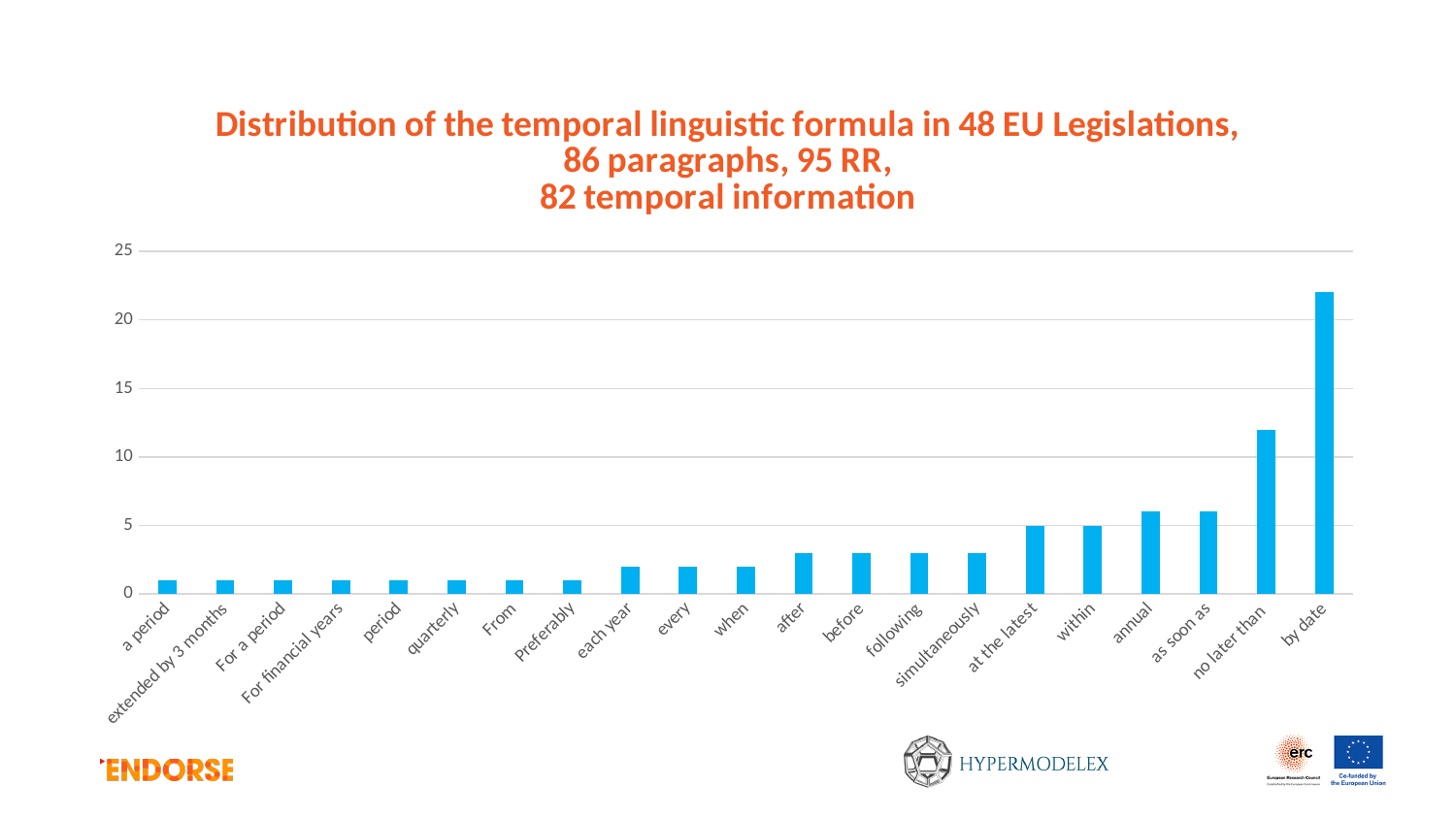
Which category has the highest value? by date How many categories are shown on the x axis? 21 What is the title of the chart? Distribution of the temporal linguistic formula in 48 EU Legislations, 86 paragraphs, 95 RR, 82 temporal information Which is larger, the value for 'annual' or the value for 'after'? annual Do the values generally rise or fall from left to right along the x axis? rise Is the value for 'a period' greater or less than 5? less Is the value for 'as soon as' greater or less than 10? less Is the value for 'by date' greater or less than 20? greater What kind of chart is shown on the slide? bar chart Which is larger, the value for 'by date' or the value for 'no later than'? by date